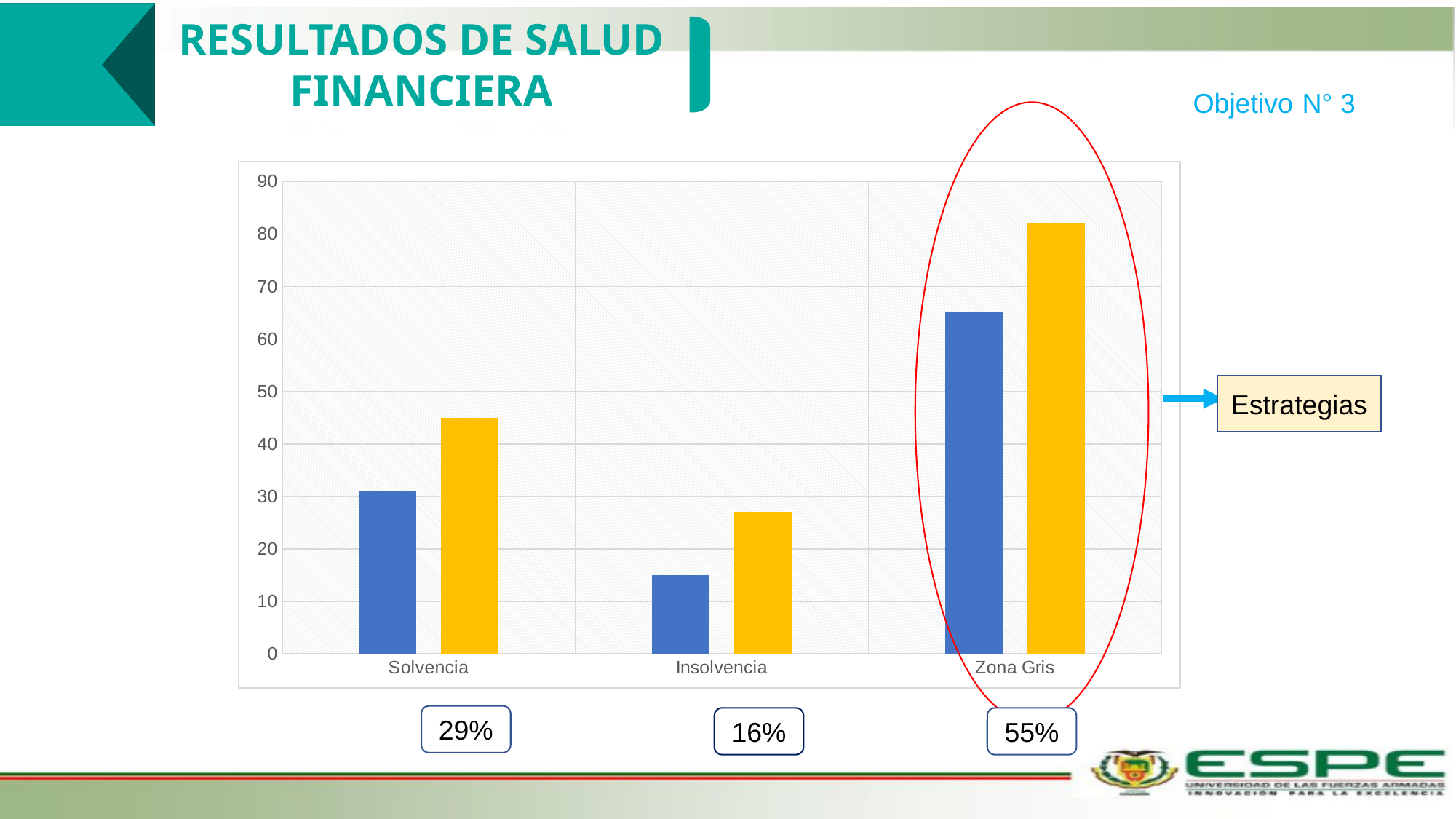
Is the value of the yellow bar for Solvencia greater or less than 40? greater What kind of chart is shown on the slide? bar chart What percentage is shown in the box below the Zona Gris category? 55% For Solvencia, which bar is taller, the blue one or the yellow one? the yellow one Is the value of the blue bar for Insolvencia greater or less than 20? less Which category has the shortest bars in the chart? Insolvencia Is the value of the blue bar for Zona Gris greater or less than 60? greater Which category has the tallest bars in the chart? Zona Gris How many categories are shown on the x axis of the chart? 3 Which category is circled in red on the chart? Zona Gris